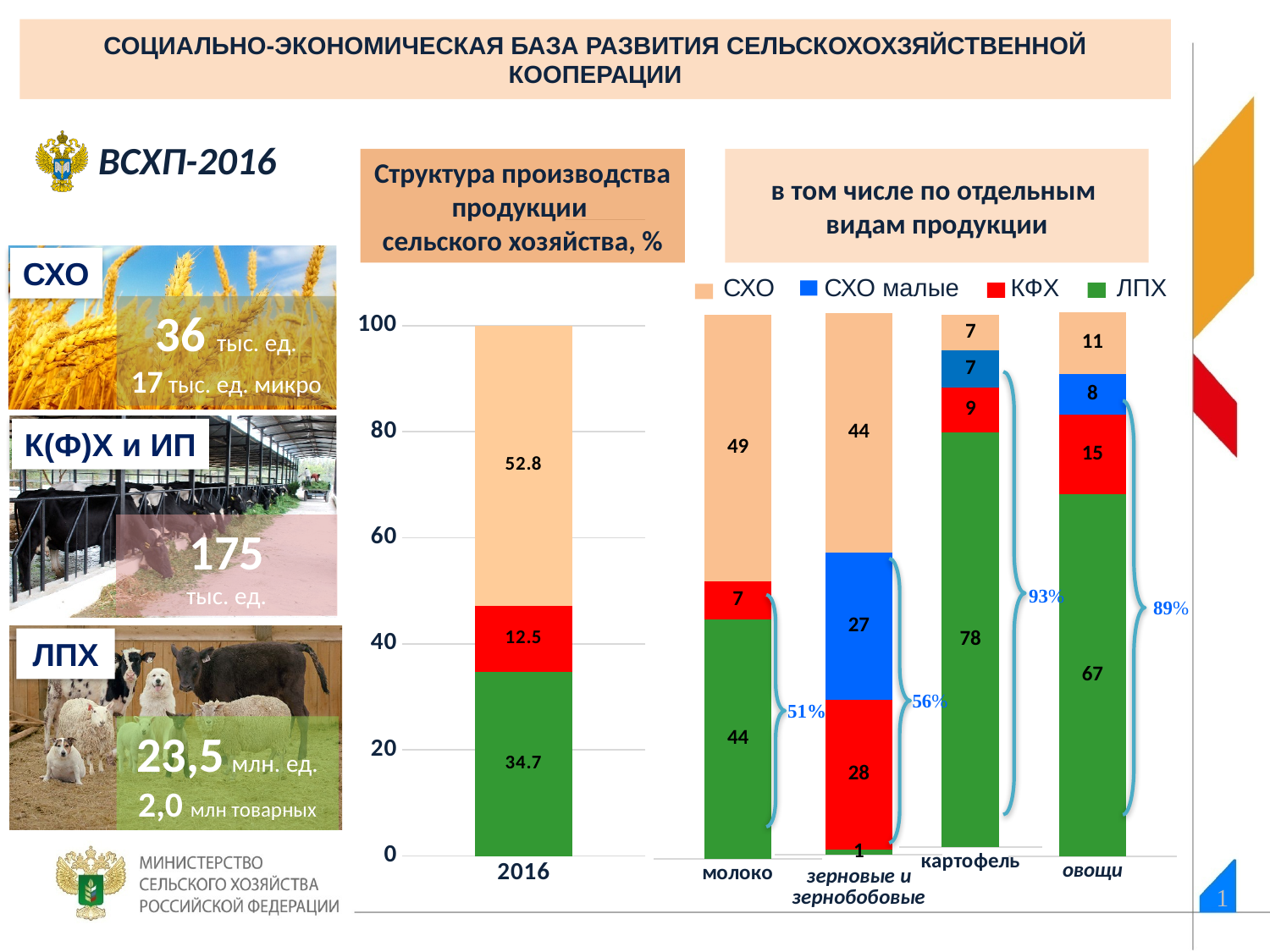
In the chart 'Структура производства продукции сельского хозяйства, %', what is the difference between the СХО and КФХ segments for 2016? 40.3 In the chart 'в том числе по отдельным видам продукции', what is the ЛПХ value for картофель? 78 In the chart 'в том числе по отдельным видам продукции', is the КФХ value larger for овощи or for картофель? овощи In the chart 'в том числе по отдельным видам продукции', what is the СХО малые value for зерновые и зернобобовые? 27 In the chart 'Структура производства продукции сельского хозяйства, %', what is the total of the stacked bar for 2016? 100 In the chart 'в том числе по отдельным видам продукции', how many product categories are shown on the x axis? 4 In the chart 'в том числе по отдельным видам продукции', which category has the highest ЛПХ value? картофель In the chart 'в том числе по отдельным видам продукции', which category has the lowest ЛПХ value? зерновые и зернобобовые In the chart 'в том числе по отдельным видам продукции', how many series does the legend list? 4 In the chart 'Структура производства продукции сельского хозяйства, %', what is the value of the ЛПХ segment for 2016? 34.7 In the chart 'Структура производства продукции сельского хозяйства, %', what is the value of the СХО segment for 2016? 52.8 What type of chart is 'в том числе по отдельным видам продукции'? stacked bar chart